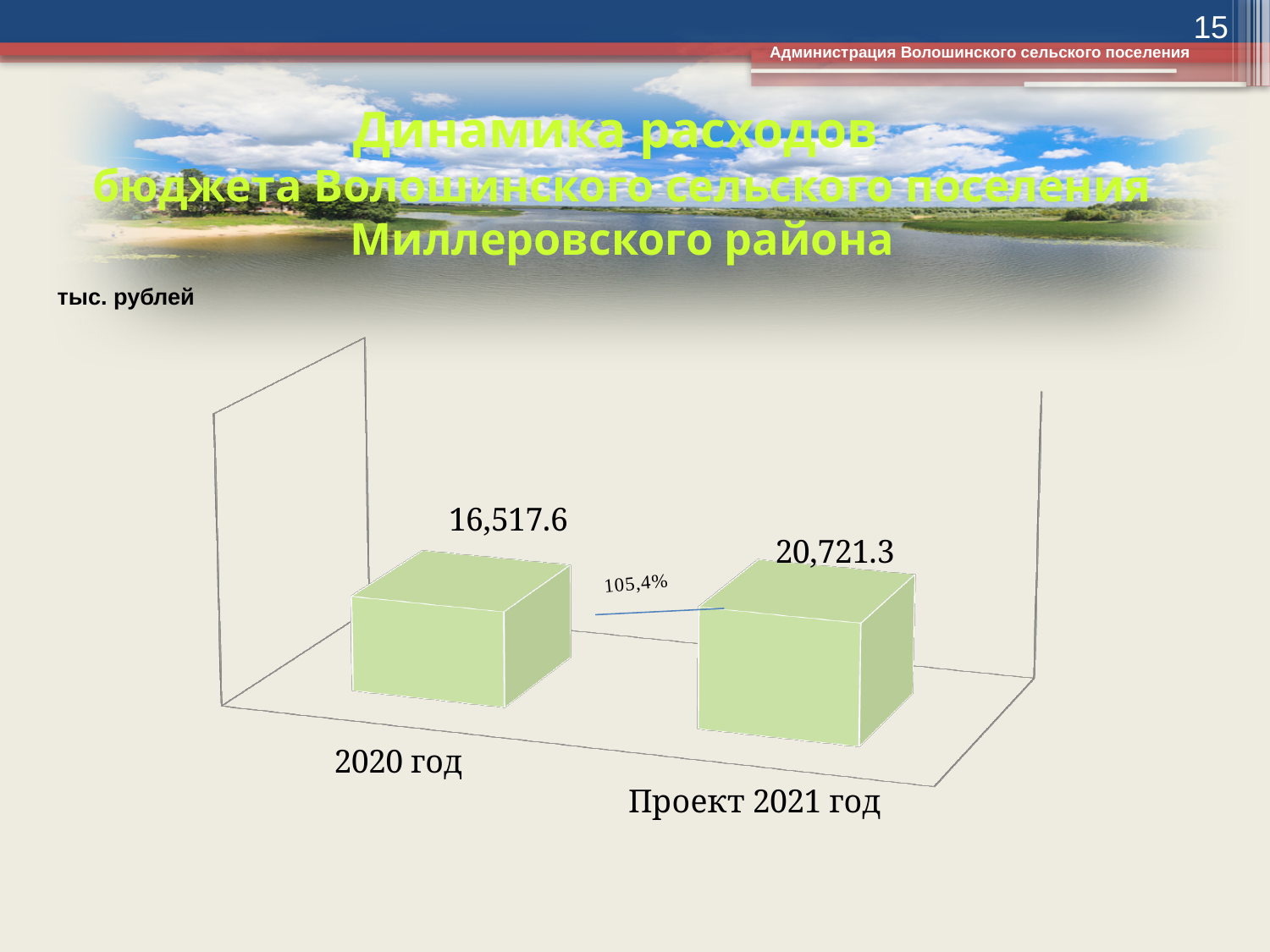
Which is larger, the value for 2020 год or the value for Проект 2021 год? Проект 2021 год What unit of measurement is indicated above the chart? тыс. рублей Which category has the highest value? Проект 2021 год What kind of chart is shown on the slide? Bar chart What percentage is printed between the two bars? 105,4% What is the difference between the values for Проект 2021 год and 2020 год? 4,203.7 Which category has the lowest value? 2020 год What is the value shown for 2020 год? 16,517.6 What is the value shown for Проект 2021 год? 20,721.3 How many categories are plotted in the chart? 2 Do the values rise or fall from 2020 год to Проект 2021 год? Rise